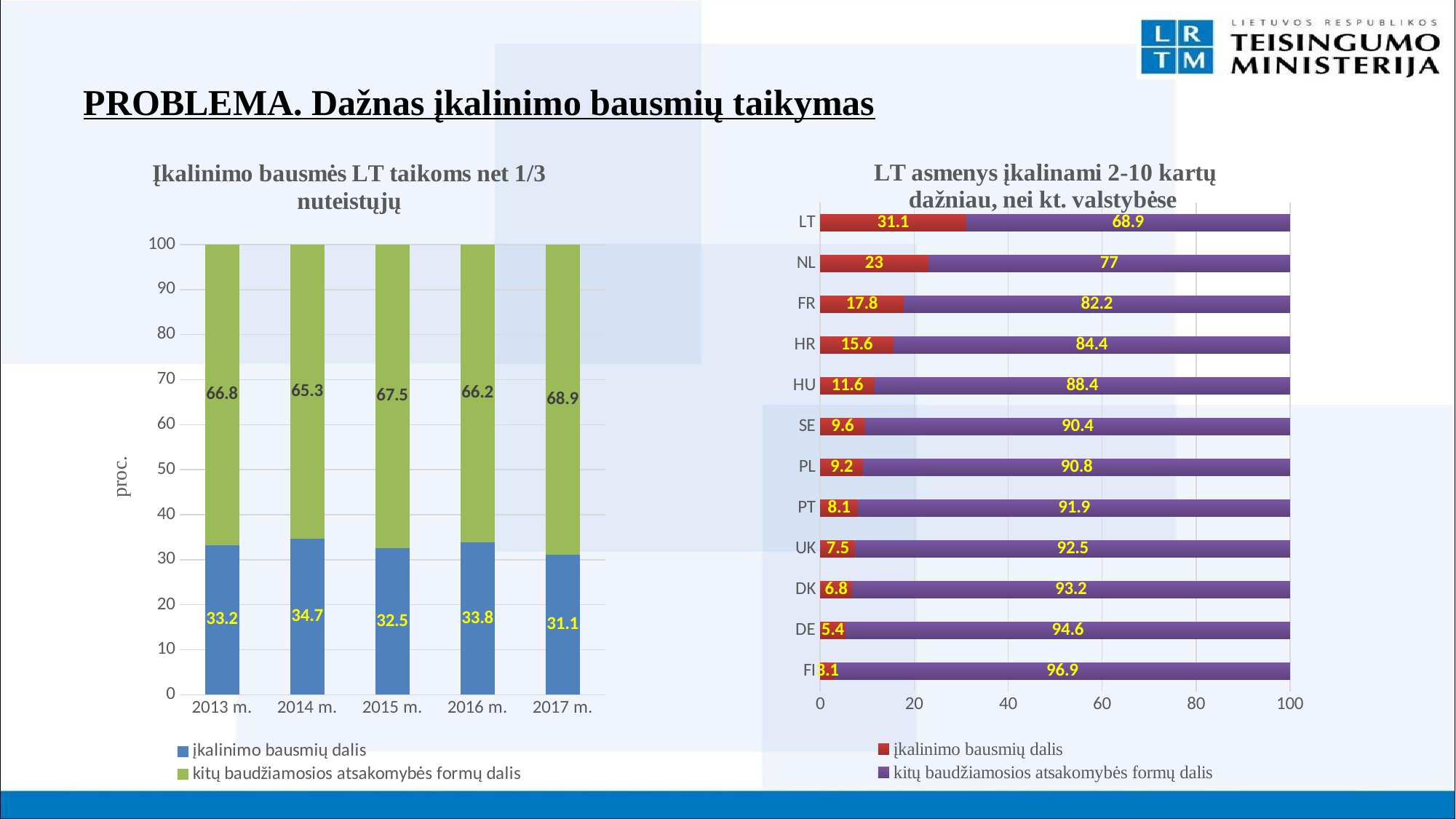
In the right chart, which country has the lowest įkalinimo bausmių dalis? FI In the right chart, how many countries are listed? 12 In the left chart, which year has the lowest įkalinimo bausmių dalis? 2017 m. What kind of chart is the right chart? Stacked bar chart In the left chart, what is the total of the stacked bar for 2015 m.? 100 In the left chart, which year has the highest įkalinimo bausmių dalis? 2014 m. In the left chart, how many years are shown on the x axis? 5 In the right chart (LT asmenys įkalinami 2-10 kartų dažniau, nei kt. valstybėse), what is the įkalinimo bausmių dalis value for NL? 23 In the right chart, which is larger, the įkalinimo bausmių dalis for FR or for HR? FR In the left chart (Įkalinimo bausmės LT taikoms net 1/3 nuteistųjų), what is the value of įkalinimo bausmių dalis for 2014 m.? 34.7 In the left chart, what is the difference between the įkalinimo bausmių dalis values for 2014 m. and 2017 m.? 3.6 In the left chart, what is the value of kitų baudžiamosios atsakomybės formų dalis for 2017 m.? 68.9